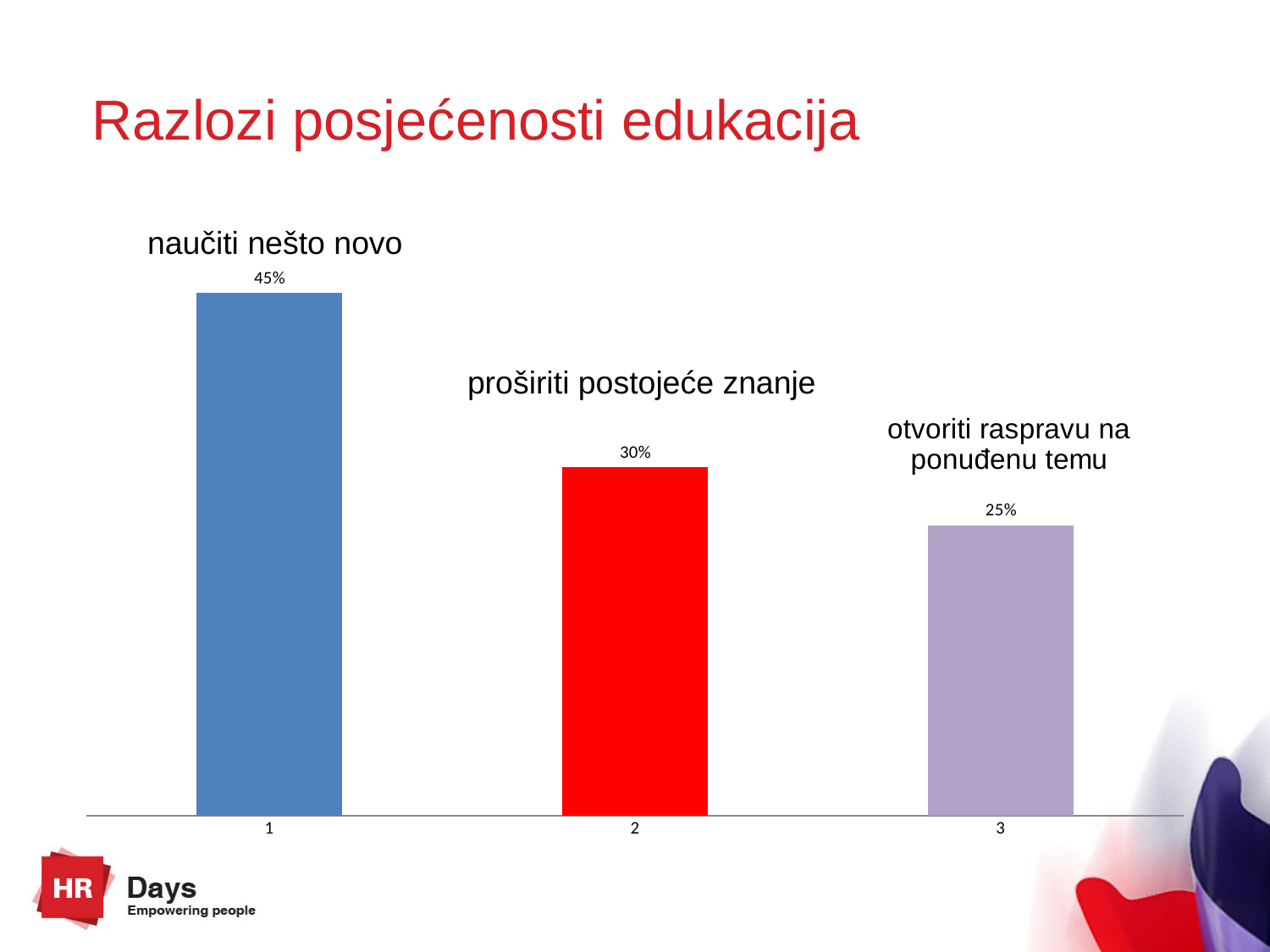
Which reason has the lowest value? otvoriti raspravu na ponuđenu temu Which reason has the highest value? naučiti nešto novo What is the difference between the values for "naučiti nešto novo" and "proširiti postojeće znanje"? 15% Which is larger, the value for "naučiti nešto novo" or for "otvoriti raspravu na ponuđenu temu"? naučiti nešto novo What is the difference between the values for "proširiti postojeće znanje" and "otvoriti raspravu na ponuđenu temu"? 5% Do the values rise or fall from left to right across the bars? fall What is the value for "proširiti postojeće znanje"? 30% What is the title of the slide? Razlozi posjećenosti edukacija What kind of chart is shown on the slide? bar chart What is the value for "otvoriti raspravu na ponuđenu temu"? 25% How many bars are shown in the chart? 3 What is the value for "naučiti nešto novo"? 45%